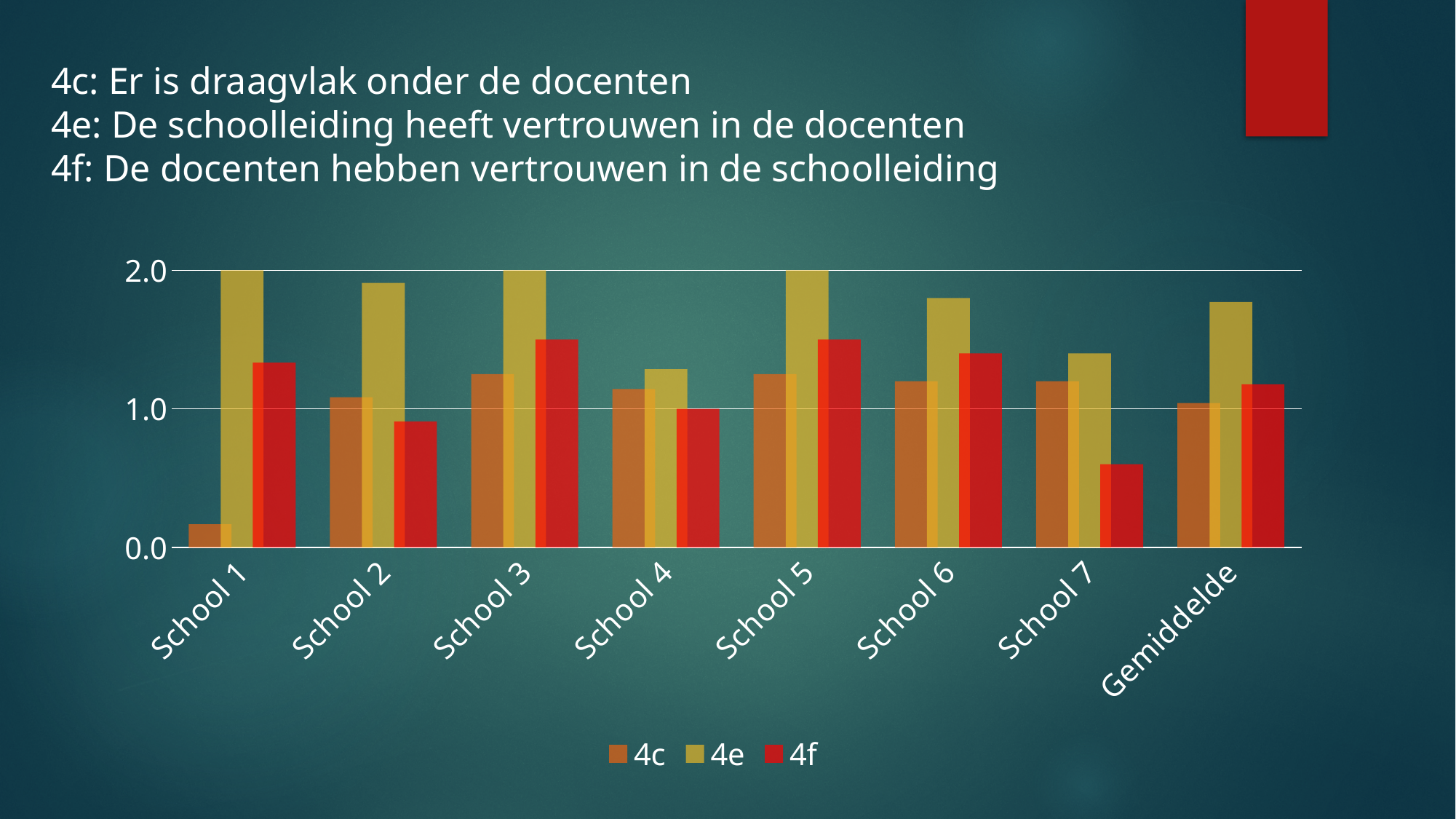
How many series does the chart's legend list? 3 Is the value of 4c for School 1 greater or less than 1.0? less Is the value of 4f for School 3 greater or less than 1.0? greater Which category has the lowest value for 4c? School 1 What kind of chart is shown on the slide? bar chart What is the value of 4e for School 1? 2.0 How many categories are shown along the x axis of the chart? 8 Is the value of 4f for School 7 greater or less than 1.0? less What is the value of 4f for School 4? 1.0 For School 7, which is larger: the value of 4c or the value of 4f? 4c Which series is shown in red in the chart's legend? 4f Which category has the lowest value for 4f? School 7